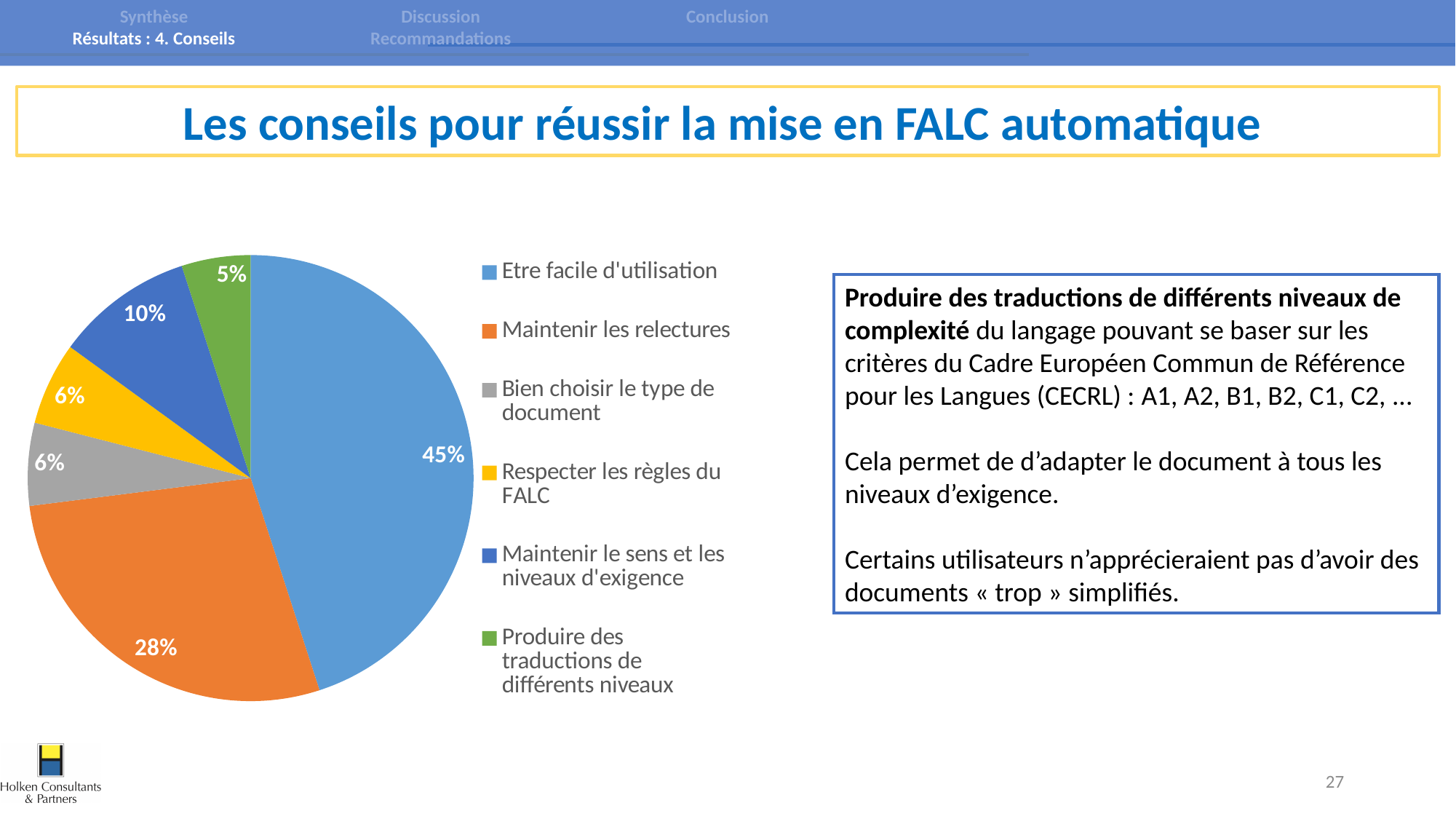
What is the value shown for "Maintenir les relectures"? 28% What share of the pie does "Etre facile d'utilisation" represent? 45% What kind of chart is shown on the slide? Pie chart Which category has the largest slice of the pie? Etre facile d'utilisation What is the value shown for "Respecter les règles du FALC"? 6% Which is larger: "Maintenir le sens et les niveaux d'exigence" or "Bien choisir le type de document"? Maintenir le sens et les niveaux d'exigence Which colour represents "Maintenir les relectures" in the pie chart? Orange What is the value shown for "Produire des traductions de différents niveaux"? 5% How many categories does the pie chart have? 6 What is the difference in percentage points between "Etre facile d'utilisation" and "Maintenir les relectures"? 17 What is the value shown for "Maintenir le sens et les niveaux d'exigence"? 10% Which category has the smallest slice of the pie? Produire des traductions de différents niveaux